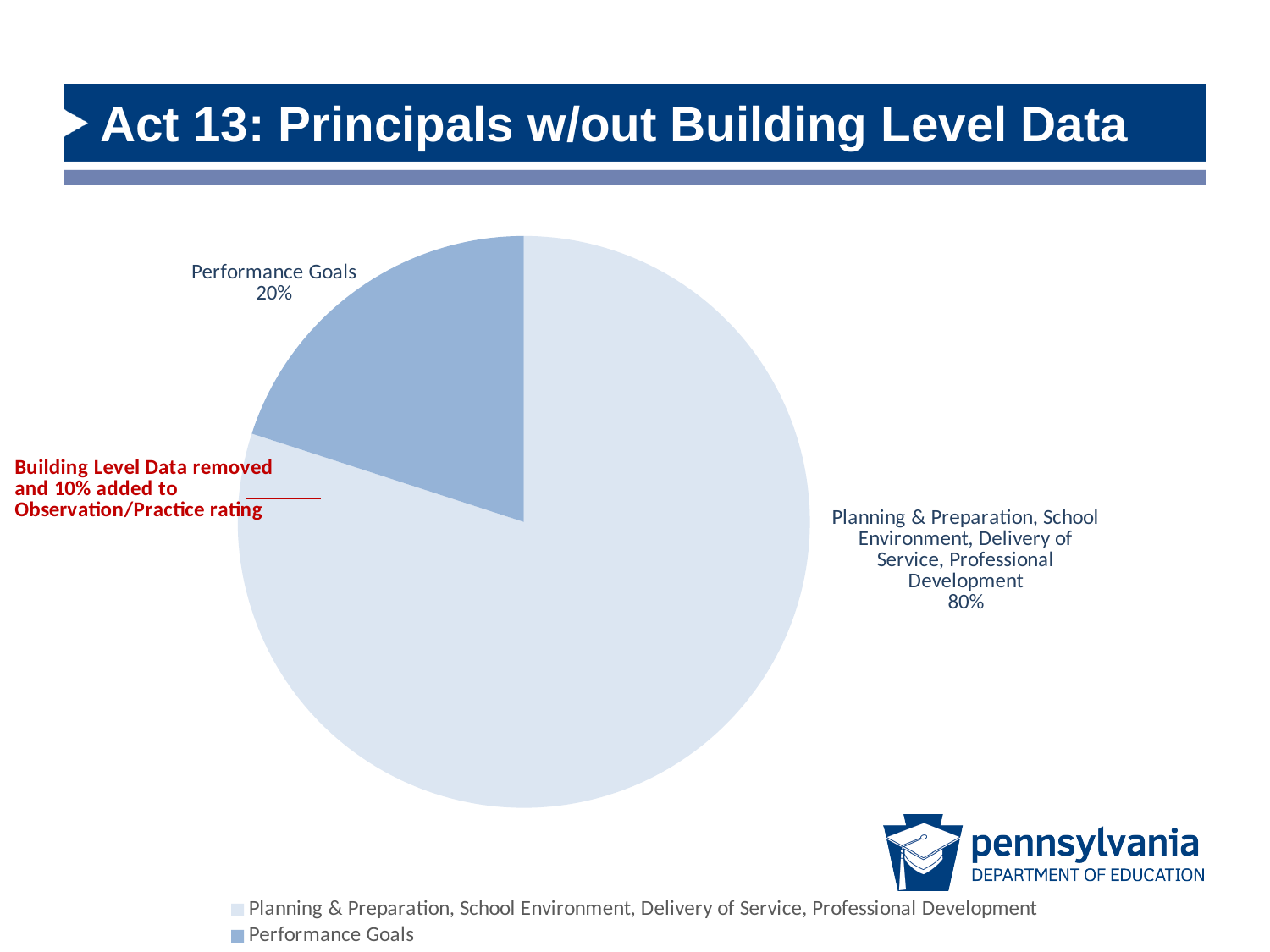
What is the difference in percentage points between the two slices of the pie? 60 percentage points Which slice of the pie is the smallest? Performance Goals What share of the pie does Performance Goals represent? 20% What share of the pie does the Planning & Preparation, School Environment, Delivery of Service, Professional Development slice represent? 80% What is the title of the slide containing the pie chart? Act 13: Principals w/out Building Level Data Which slice of the pie is the largest? Planning & Preparation, School Environment, Delivery of Service, Professional Development What kind of chart is shown on the slide? pie chart Which is larger: the Performance Goals slice or the Planning & Preparation, School Environment, Delivery of Service, Professional Development slice? Planning & Preparation, School Environment, Delivery of Service, Professional Development How many slices does the pie chart have? 2 What does the red annotation next to the pie chart say? Building Level Data removed and 10% added to Observation/Practice rating How many entries does the legend list? 2